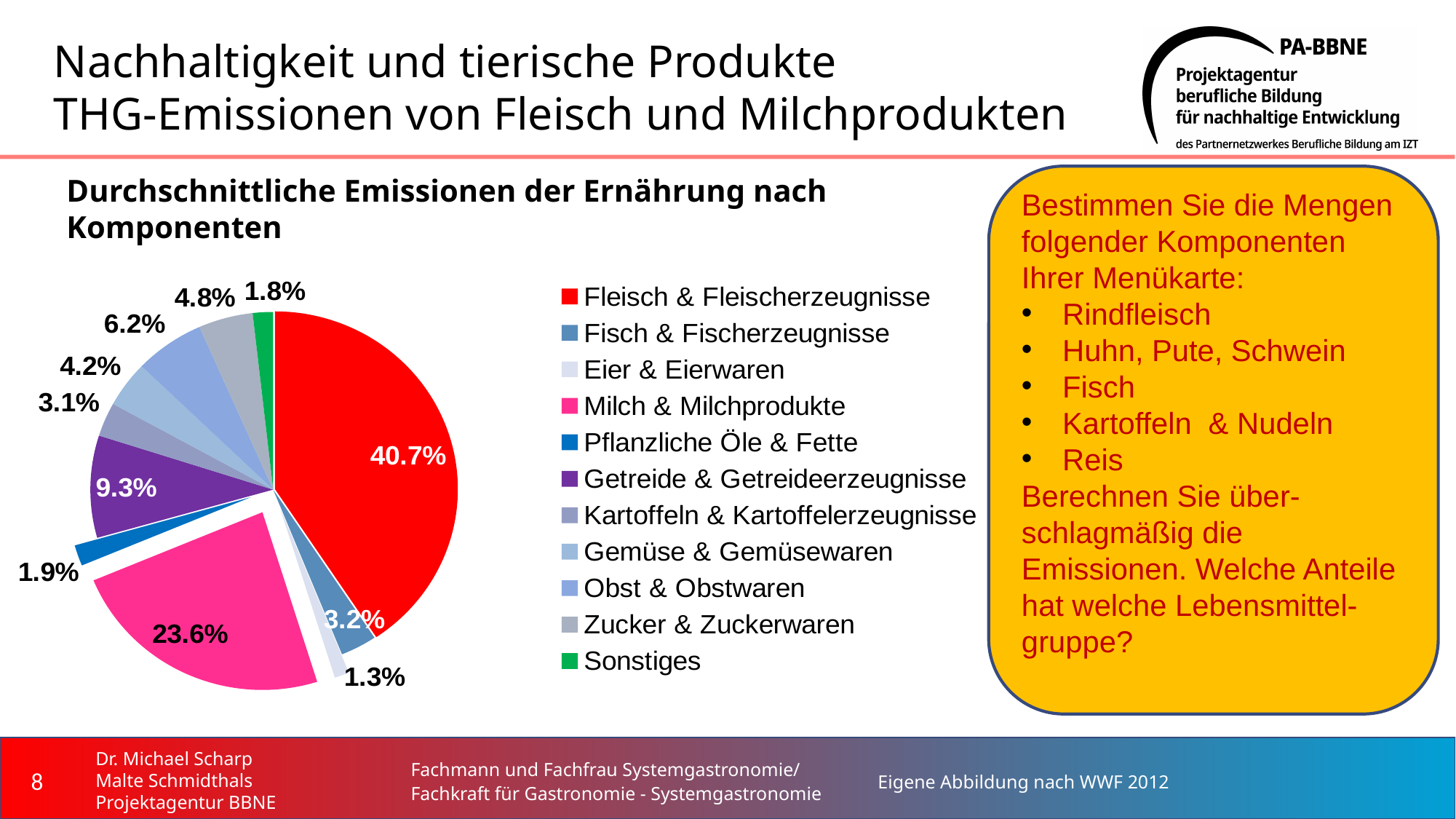
What is the title of the chart? Durchschnittliche Emissionen der Ernährung nach Komponenten What share of the pie does Obst & Obstwaren have? 6.2% What share of the pie does Eier & Eierwaren have? 1.3% What is the difference in percentage points between Fleisch & Fleischerzeugnisse and Milch & Milchprodukte? 17.1 What kind of chart is shown on the slide? pie chart What share of the pie does Milch & Milchprodukte have? 23.6% Which category has the smallest share of the pie? Eier & Eierwaren What share of the pie does Fleisch & Fleischerzeugnisse have? 40.7% Which is larger, the share for Fisch & Fischerzeugnisse or the share for Gemüse & Gemüsewaren? Gemüse & Gemüsewaren How many categories does the legend list? 11 What share of the pie does Getreide & Getreideerzeugnisse have? 9.3% Which category has the largest share of the pie? Fleisch & Fleischerzeugnisse